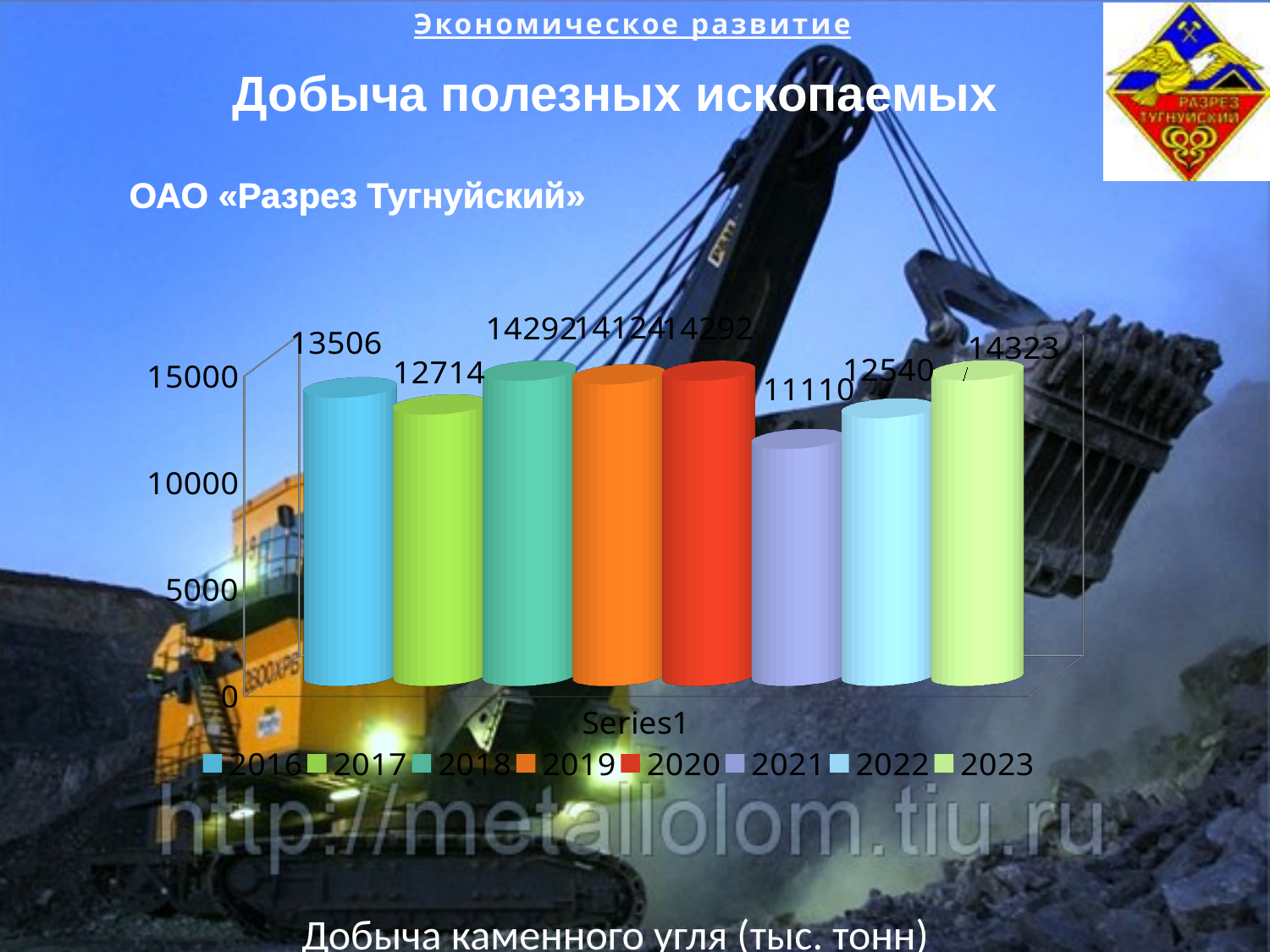
What is the value for 2023? 14323 How many series does the legend list? 8 What is the value for 2017? 12714 Which year has the lowest value? 2021 What kind of chart is shown on the slide? bar chart What is the value for 2022? 12540 What is the difference between the values for 2016 and 2017? 792 Which is larger, the value for 2017 or the value for 2022? 2017 What is the value for 2021? 11110 Which year has the highest value? 2023 What is the value for 2016? 13506 What is the difference between the values for 2023 and 2021? 3213